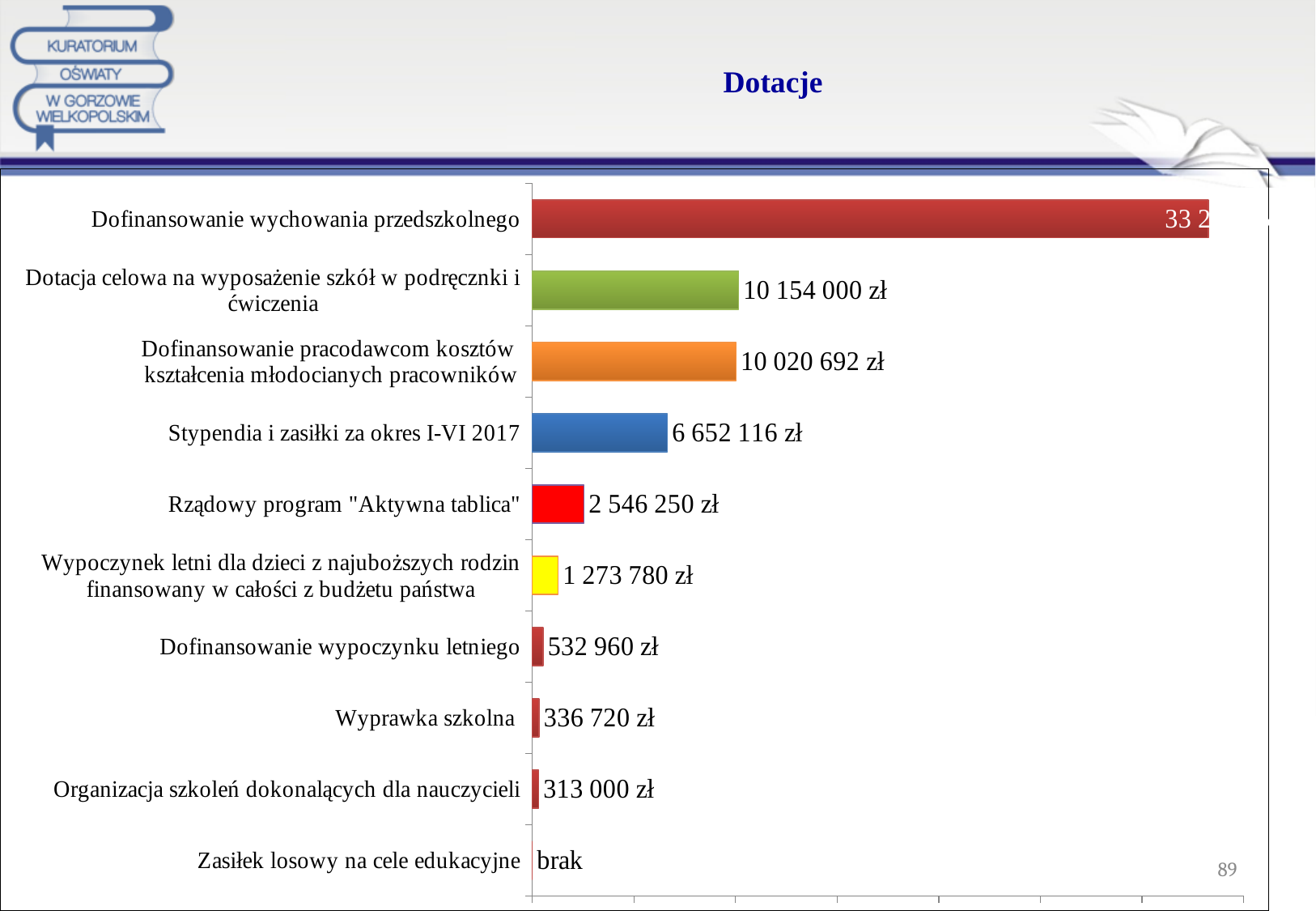
How many categories are listed on the chart? 10 What is the value for "Rządowy program "Aktywna tablica""? 2 546 250 zł What is the value for "Wyprawka szkolna"? 336 720 zł What is the value for "Organizacja szkoleń dokonalących dla nauczycieli"? 313 000 zł What is shown for "Zasiłek losowy na cele edukacyjne"? brak What is the value for "Dotacja celowa na wyposażenie szkół w podręczniki i ćwiczenia"? 10 154 000 zł What kind of chart is shown on the slide? bar chart Which category has the highest value? Dofinansowanie wychowania przedszkolnego Which is larger: "Dotacja celowa na wyposażenie szkół w podręczniki i ćwiczenia" or "Dofinansowanie pracodawcom kosztów kształcenia młodocianych pracowników"? Dotacja celowa na wyposażenie szkół w podręczniki i ćwiczenia What is the difference between "Stypendia i zasiłki za okres I-VI 2017" and "Rządowy program "Aktywna tablica""? 4 105 866 zł What is the title of the chart? Dotacje What is the value for "Stypendia i zasiłki za okres I-VI 2017"? 6 652 116 zł